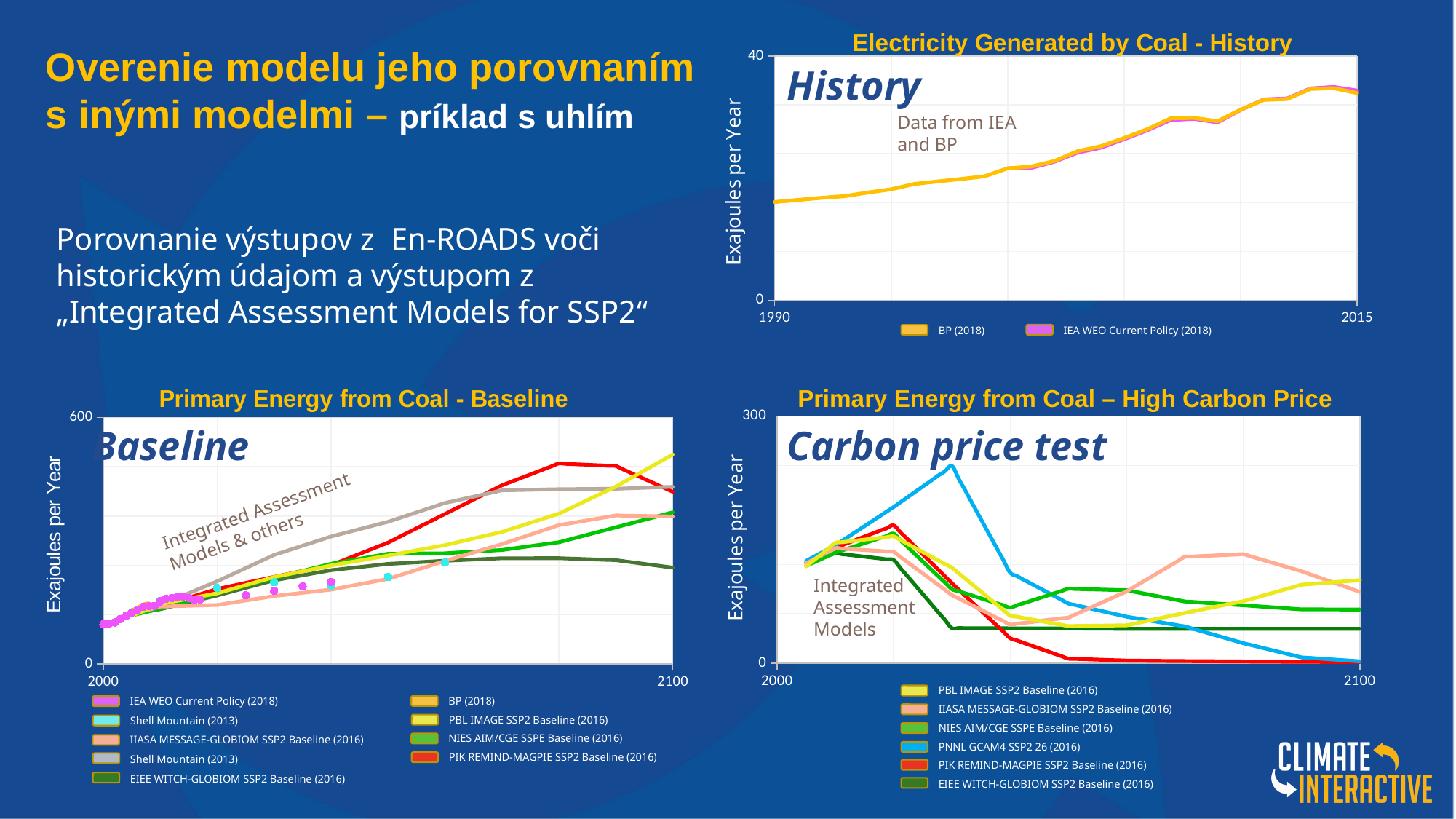
In the 'Primary Energy from Coal – High Carbon Price' chart, is the peak value of PNNL GCAM4 SSP2 26 (2016) greater or less than 300? less How many series does the legend of the 'Primary Energy from Coal – High Carbon Price' chart list? 6 In the 'Primary Energy from Coal - Baseline' chart, which series has the highest value at 2100? PBL IMAGE SSP2 Baseline (2016) In the 'Primary Energy from Coal - Baseline' chart, which is larger at 2100: PIK REMIND-MAGPIE SSP2 Baseline (2016) or EIEE WITCH-GLOBIOM SSP2 Baseline (2016)? PIK REMIND-MAGPIE SSP2 Baseline (2016) In the 'Electricity Generated by Coal - History' chart, is the value in 2015 greater or less than 40? less In the 'Primary Energy from Coal - Baseline' chart, which series has the lowest value at 2100? EIEE WITCH-GLOBIOM SSP2 Baseline (2016) How many series does the legend of the 'Electricity Generated by Coal - History' chart list? 2 What is the y-axis label of the 'Electricity Generated by Coal - History' chart? Exajoules per Year How many series does the legend of the 'Primary Energy from Coal - Baseline' chart list? 9 In the 'Electricity Generated by Coal - History' chart, do the values rise or fall from 1990 to 2015? Rise In the 'Primary Energy from Coal – High Carbon Price' chart, which series reaches the highest peak value? PNNL GCAM4 SSP2 26 (2016) What type of chart is the 'Electricity Generated by Coal - History' chart? Line chart